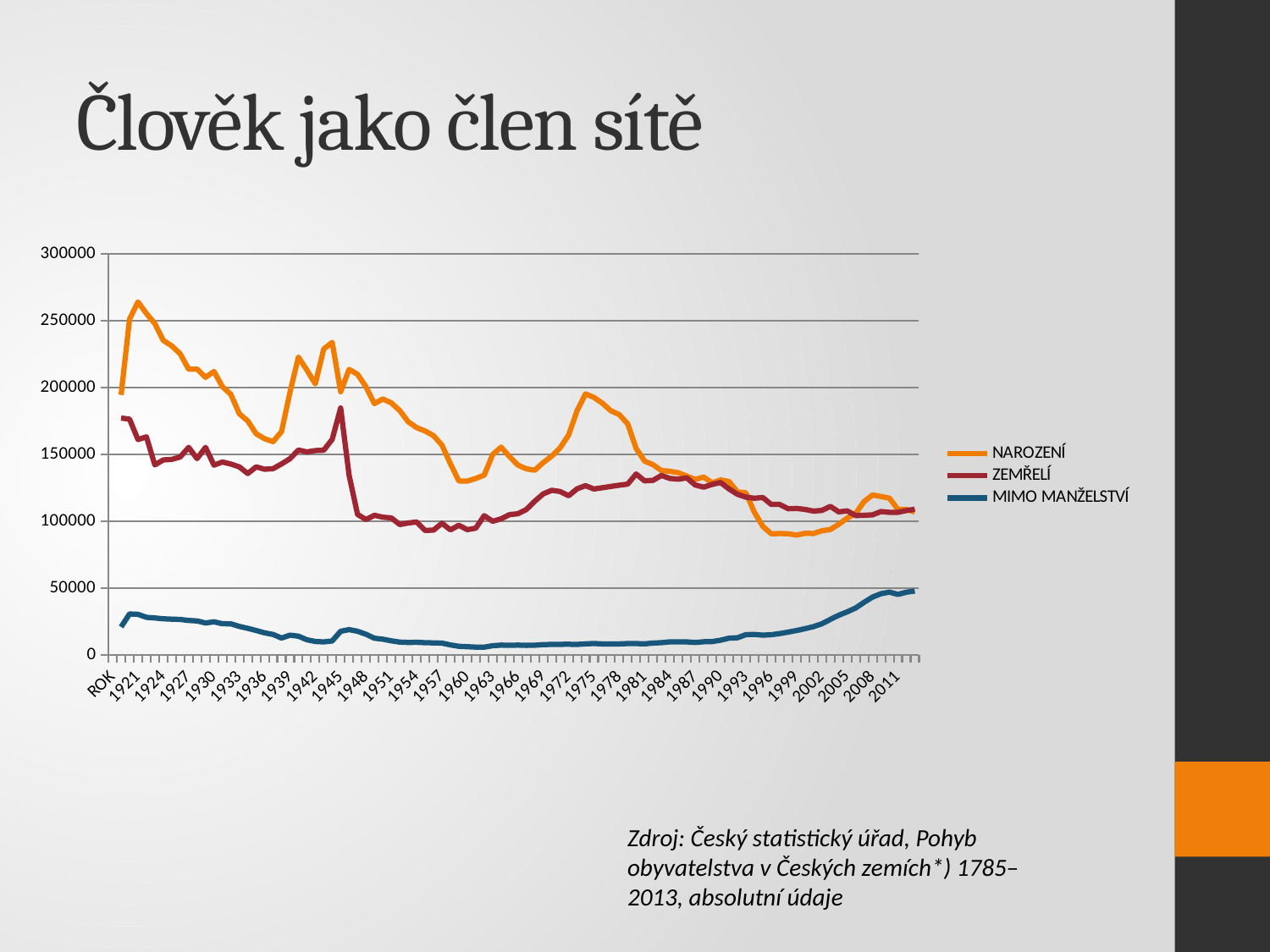
Which series are listed in the chart's legend? NAROZENÍ, ZEMŘELÍ, MIMO MANŽELSTVÍ Does the MIMO MANŽELSTVÍ line rise or fall between 1990 and 2011? rise Is the value for ZEMŘELÍ in 1951 greater or less than 150000? less In 1999, which is larger: NAROZENÍ or ZEMŘELÍ? ZEMŘELÍ Is the value for NAROZENÍ in 1921 greater or less than 250000? greater Is the value for NAROZENÍ in 1999 greater or less than 100000? less Which series has the lowest values across the whole chart? MIMO MANŽELSTVÍ How many series does the chart's legend list? 3 What kind of chart is shown on the slide? line chart What colour is the NAROZENÍ line in the chart? orange In 1975, which is larger: NAROZENÍ or ZEMŘELÍ? NAROZENÍ